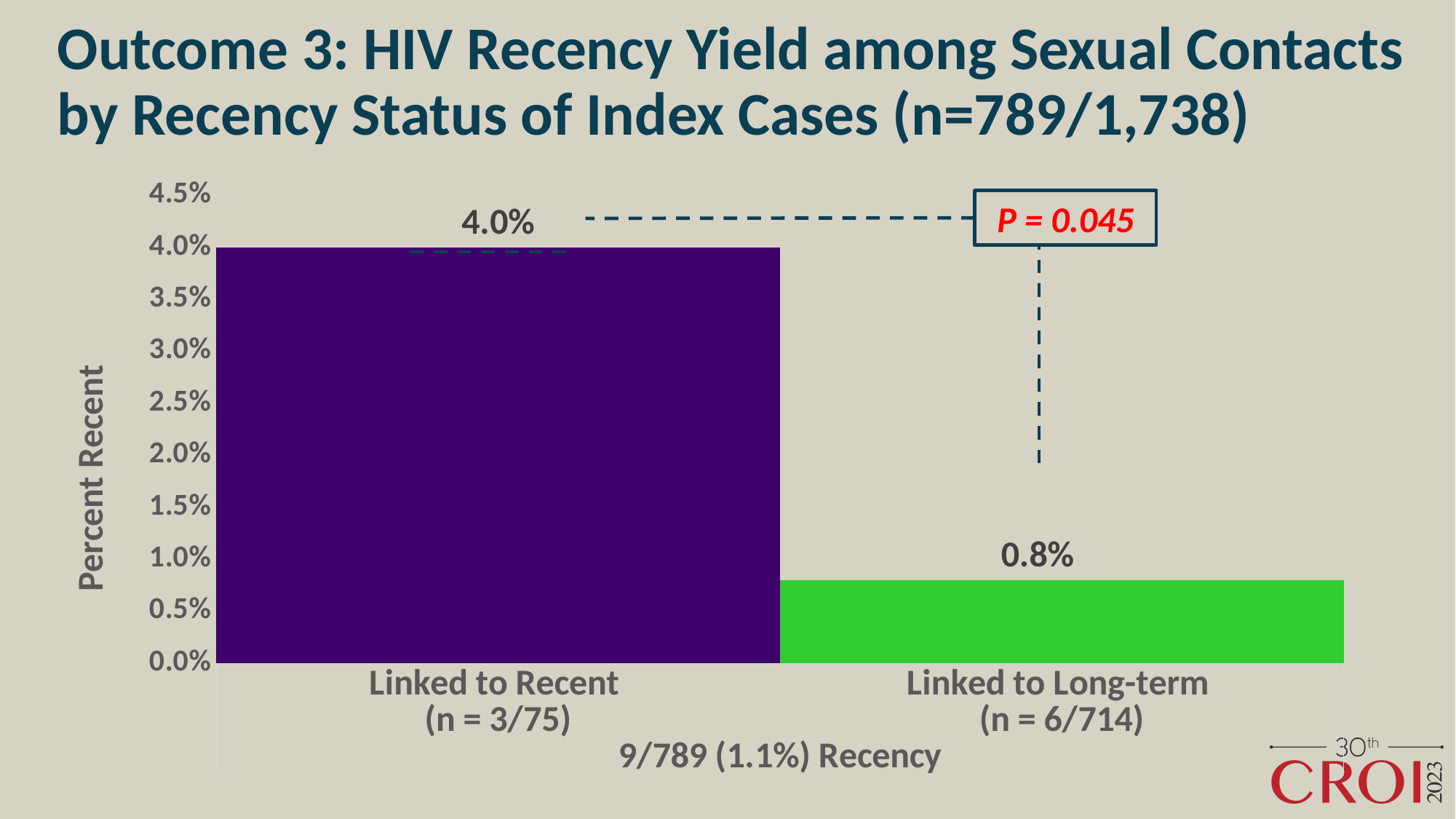
Which category has the lowest percent recent? Linked to Long-term What is the label of the y axis of the chart? Percent Recent Which is larger, the percent recent for Linked to Recent or for Linked to Long-term? Linked to Recent Is the value for Linked to Recent greater or less than 3.5%? greater What kind of chart is shown on the slide? Bar chart What is the percent recent for the Linked to Recent category? 4.0% What is the difference in percent recent between Linked to Recent and Linked to Long-term? 3.2% What is the percent recent for the Linked to Long-term category? 0.8% Is the value for Linked to Long-term greater or less than 1.0%? less Which category has the highest percent recent? Linked to Recent What P value is shown on the chart? P = 0.045 How many categories are shown on the x axis of the chart? 2